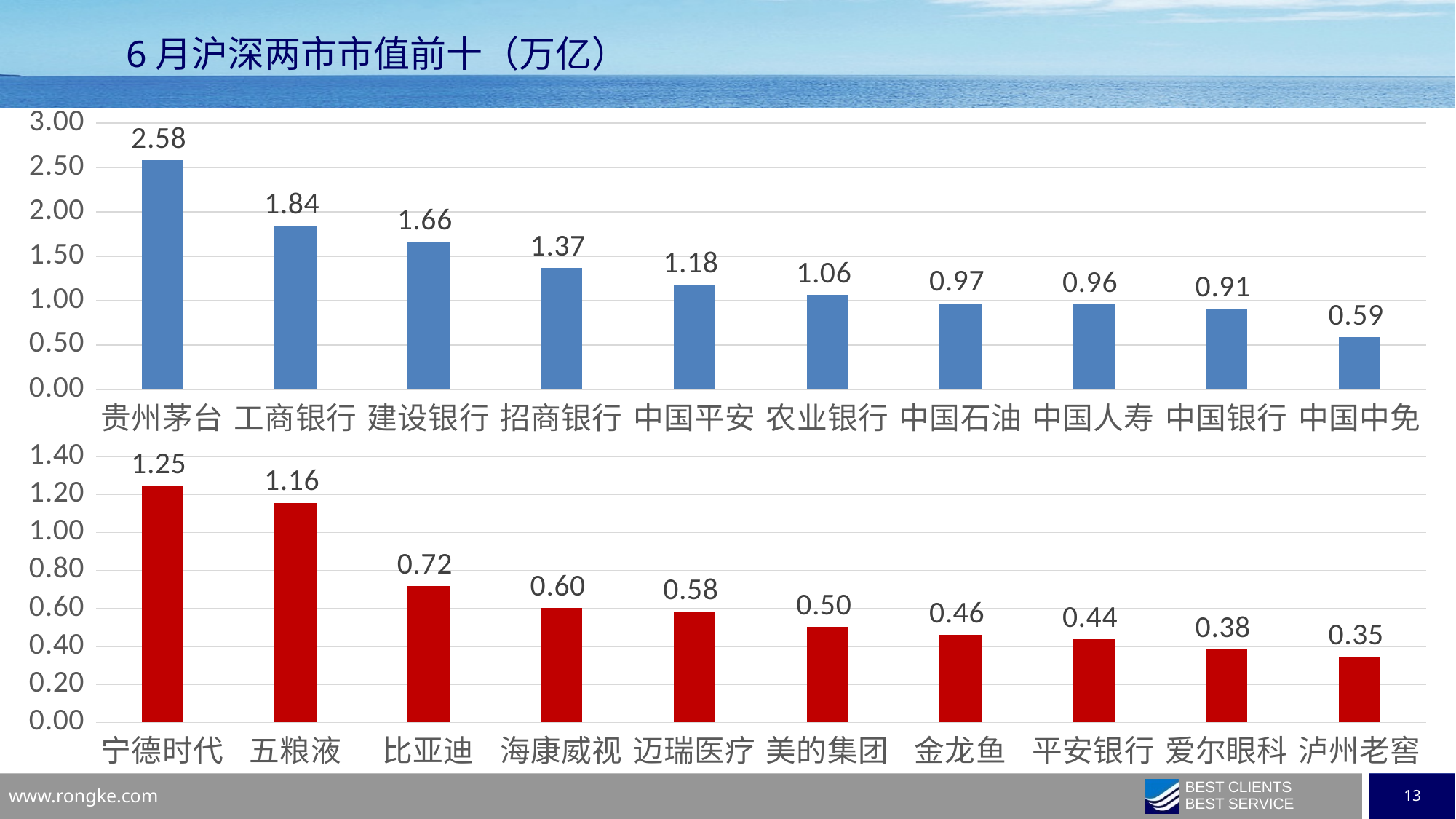
In the bottom chart (red bars), which is larger, the value for 海康威视 or the value for 美的集团? 海康威视 What kind of chart is the bottom chart (red bars)? Bar chart In the top chart (blue bars), what is the difference between the values for 工商银行 and 建设银行? 0.18 In the top chart (blue bars), which category has the lowest value? 中国中免 In the top chart (blue bars), what is the value for 招商银行? 1.37 In the bottom chart (red bars), what is the value for 比亚迪? 0.72 In the bottom chart (red bars), which category has the highest value? 宁德时代 In the bottom chart (red bars), what is the value for 泸州老窖? 0.35 In the bottom chart (red bars), what is the difference between the values for 宁德时代 and 五粮液? 0.09 In the top chart (blue bars), what is the value for 贵州茅台? 2.58 In the top chart (blue bars), do the values rise or fall from left to right? Fall How many categories are shown in the top chart (blue bars)? 10